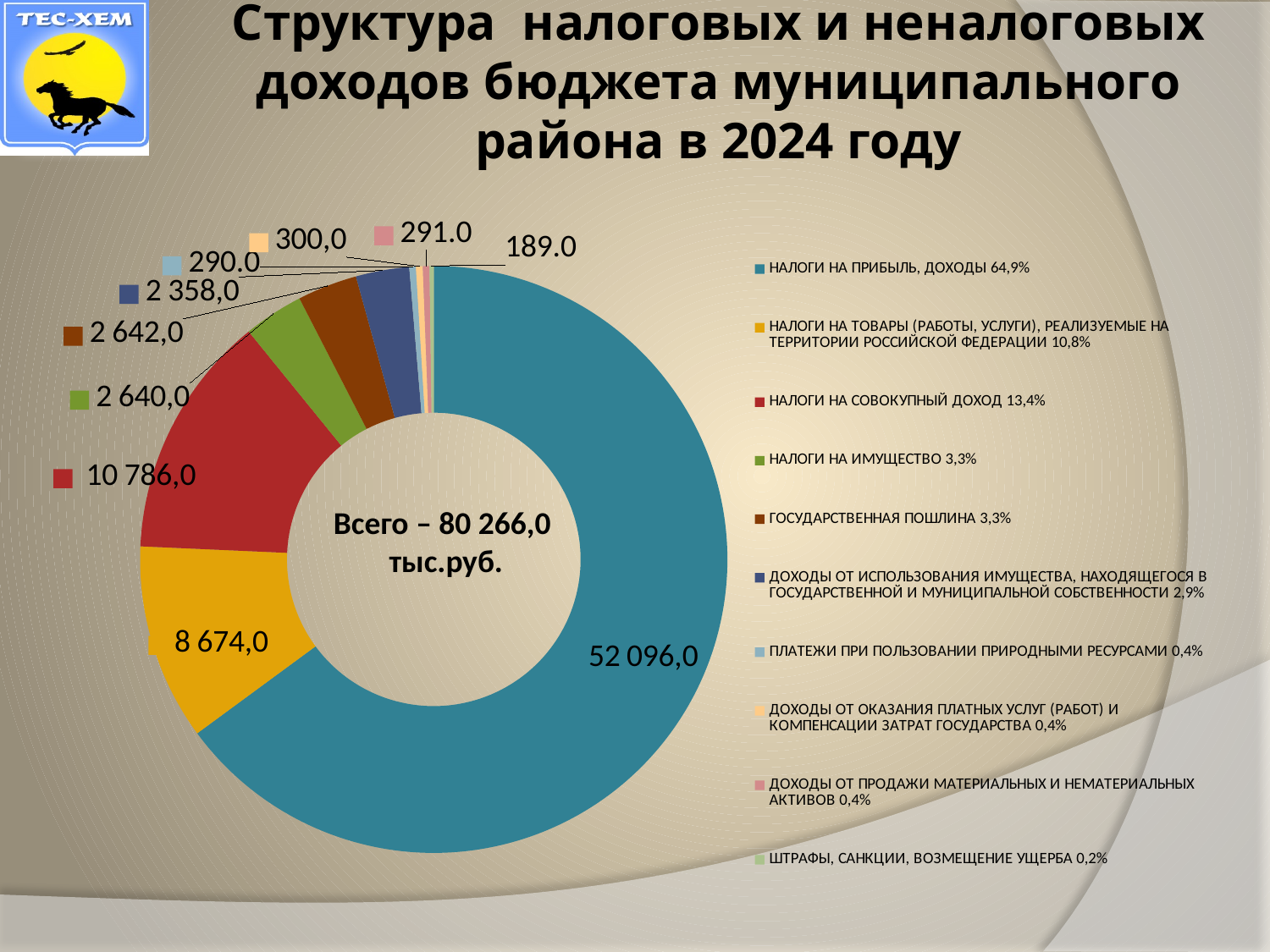
What is the difference between the values for НАЛОГИ НА СОВОКУПНЫЙ ДОХОД and НАЛОГИ НА ТОВАРЫ (РАБОТЫ, УСЛУГИ)? 2 112,0 What kind of chart is shown on the slide? doughnut (pie) chart What is the value shown for НАЛОГИ НА ТОВАРЫ (РАБОТЫ, УСЛУГИ), РЕАЛИЗУЕМЫЕ НА ТЕРРИТОРИИ РОССИЙСКОЙ ФЕДЕРАЦИИ? 8 674,0 What total is printed in the centre of the chart? 80 266,0 тыс.руб. What is the title of the slide? Структура налоговых и неналоговых доходов бюджета муниципального района в 2024 году What is the value shown for НАЛОГИ НА ПРИБЫЛЬ, ДОХОДЫ? 52 096,0 Which category has the largest value in the chart? НАЛОГИ НА ПРИБЫЛЬ, ДОХОДЫ What is the value shown for НАЛОГИ НА СОВОКУПНЫЙ ДОХОД? 10 786,0 What share of the total does НАЛОГИ НА СОВОКУПНЫЙ ДОХОД represent according to the legend? 13,4% Which is larger: the value for НАЛОГИ НА ИМУЩЕСТВО or the value for ДОХОДЫ ОТ ИСПОЛЬЗОВАНИЯ ИМУЩЕСТВА, НАХОДЯЩЕГОСЯ В ГОСУДАРСТВЕННОЙ И МУНИЦИПАЛЬНОЙ СОБСТВЕННОСТИ? НАЛОГИ НА ИМУЩЕСТВО How many categories does the legend of the chart list? 10 Which category has the smallest value in the chart? ШТРАФЫ, САНКЦИИ, ВОЗМЕЩЕНИЕ УЩЕРБА